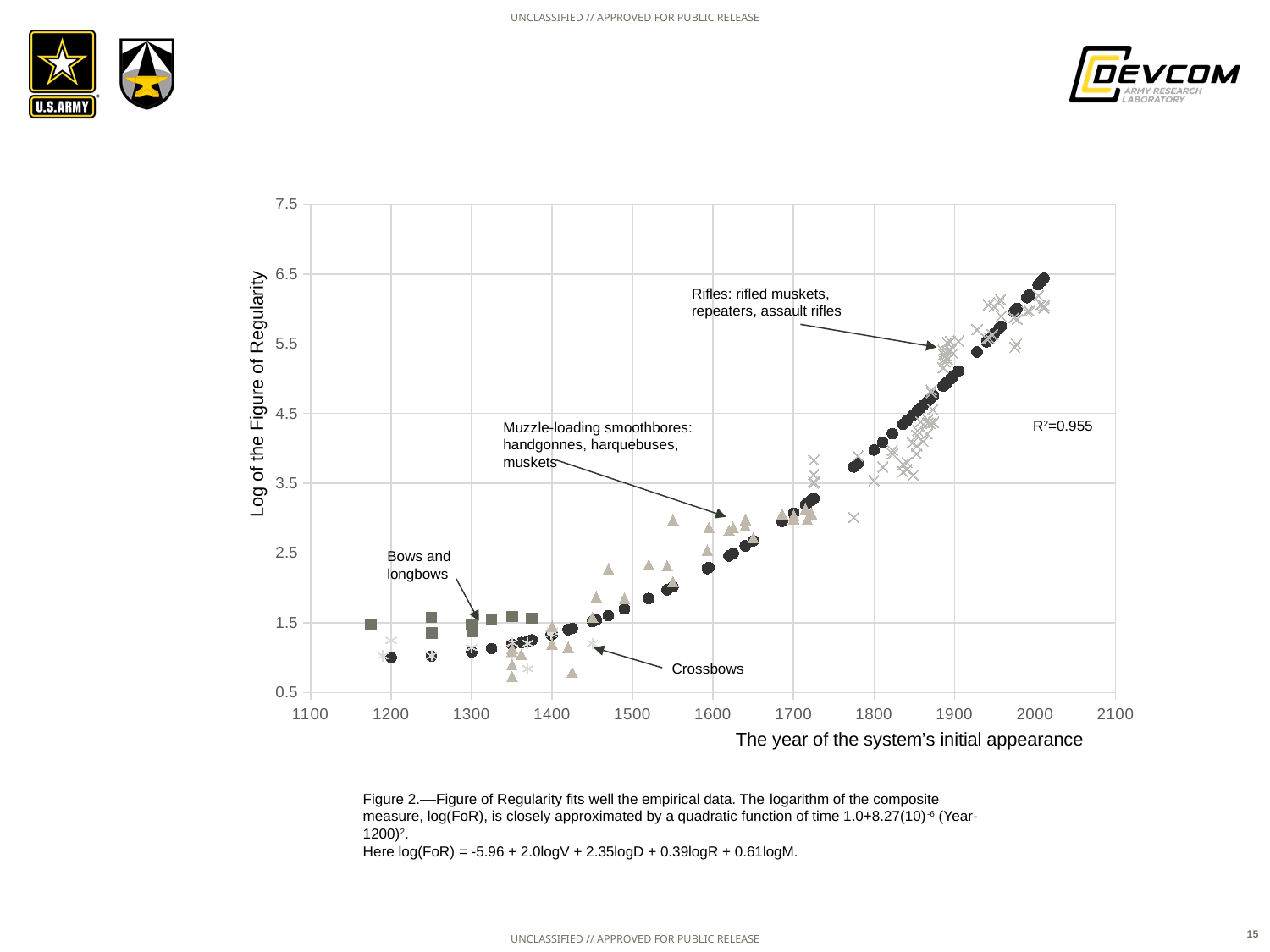
Are the values for the points labelled "Bows and longbows" greater or less than 2.5? less What is the label of the horizontal axis? The year of the system's initial appearance What kind of chart is shown on the slide? scatter chart Which group has larger values: the muzzle-loading smoothbores or the bows and longbows? Muzzle-loading smoothbores Which annotated weapon group has the highest values on the chart? Rifles: rifled muskets, repeaters, assault rifles What is the label of the vertical axis? Log of the Figure of Regularity Do the plotted values generally rise or fall as the year of initial appearance increases along the x axis? rise How many weapon groups are annotated with labels on the chart? 4 What R-squared value is printed on the chart? R²=0.955 Are the values for the points labelled "Crossbows" greater or less than 1.5? less